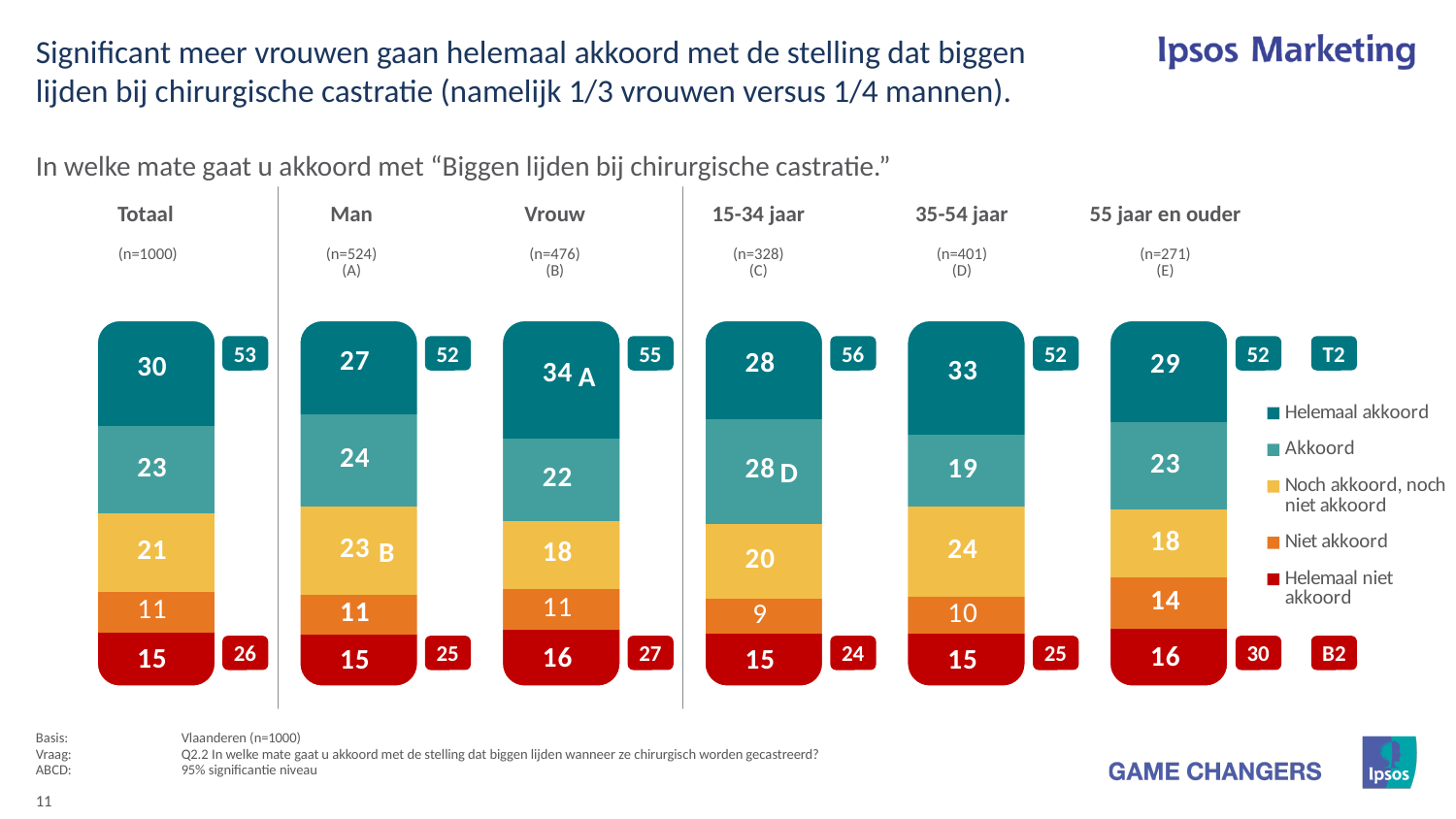
What is the difference between the "Helemaal akkoord" values for Vrouw and Man? 7 Which category has the highest value for "Helemaal akkoord"? Vrouw What is the value for "Helemaal akkoord" in the Vrouw bar? 34 Which category has the lowest value for "Niet akkoord"? 15-34 jaar How many series does the legend list? 5 What is the combined total of "Helemaal akkoord" and "Akkoord" for the Totaal bar, as shown in the label next to it? 53 What is the sample size (n) shown for the 55 jaar en ouder category? n=271 How many categories (bars) are shown in the chart? 6 What is the value for "Noch akkoord, noch niet akkoord" in the 35-54 jaar bar? 24 Which is larger: the "Akkoord" value for 15-34 jaar or for 35-54 jaar? 15-34 jaar What is the value for "Niet akkoord" in the 55 jaar en ouder bar? 14 What kind of chart is shown on the slide? Stacked bar chart